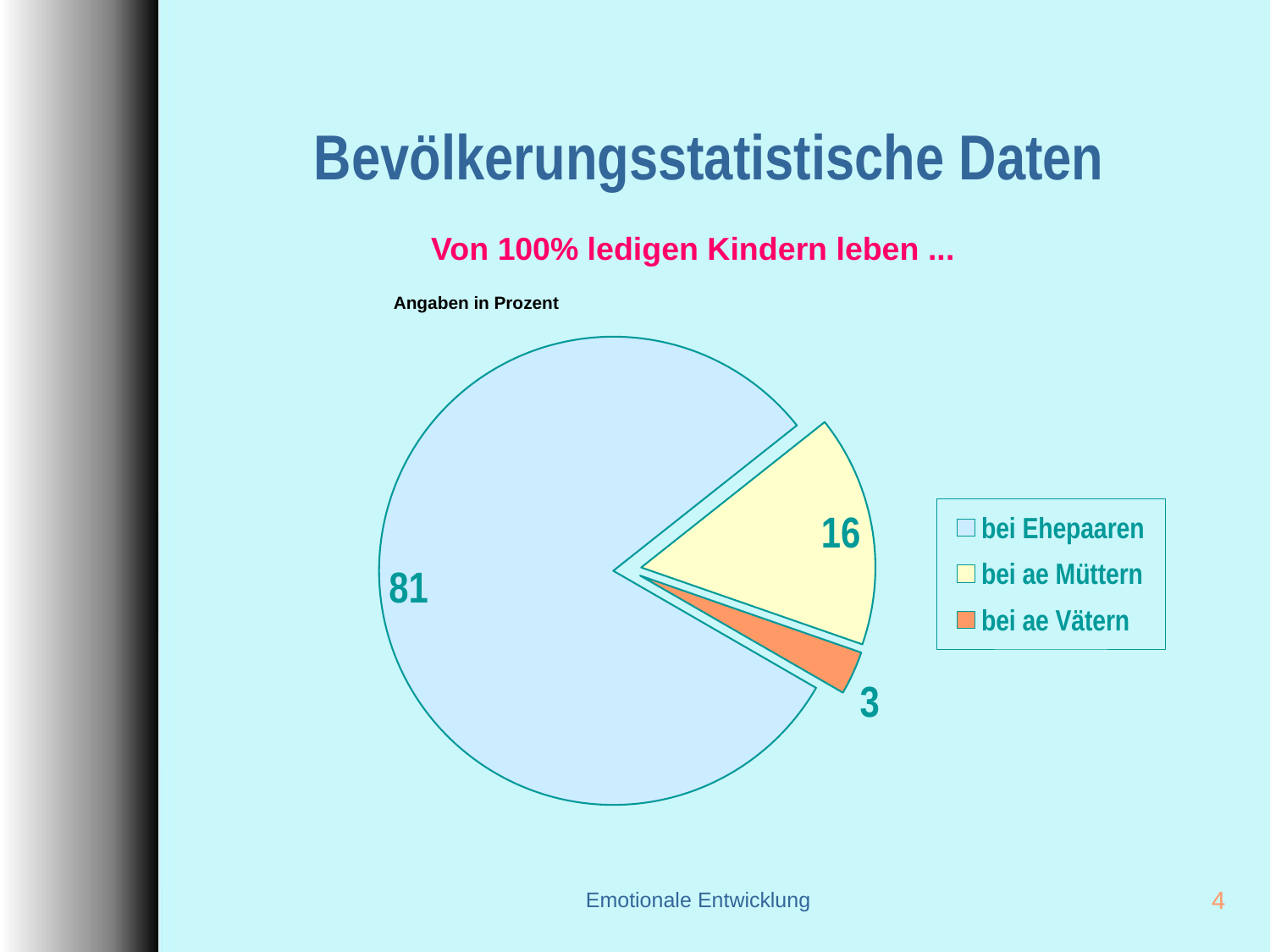
How many slices does the pie chart have? 3 What unit note is printed above the chart? Angaben in Prozent What is the value for "bei ae Müttern"? 16 What is the value for "bei ae Vätern"? 3 What is the difference between the values for "bei ae Müttern" and "bei ae Vätern"? 13 What is the difference between the values for "bei Ehepaaren" and "bei ae Müttern"? 65 Which category has the largest slice? bei Ehepaaren Which is larger, the value for "bei ae Müttern" or "bei ae Vätern"? bei ae Müttern How many entries does the legend list? 3 What kind of chart is shown on the slide? pie chart Which category has the smallest slice? bei ae Vätern What is the value for "bei Ehepaaren"? 81